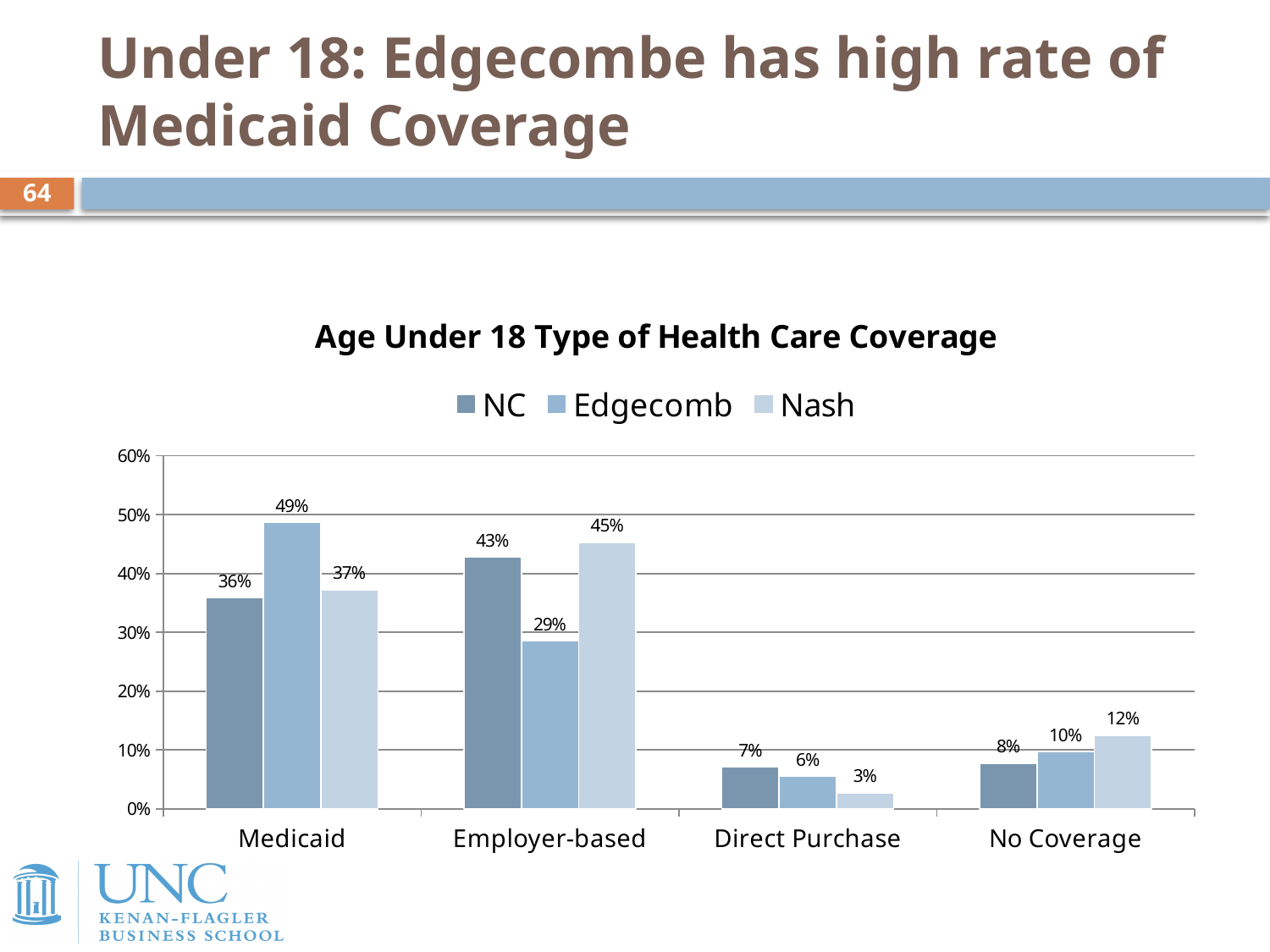
What kind of chart is shown on the slide? Bar chart Which category has the highest Edgecomb value? Medicaid What is the title of the chart? Age Under 18 Type of Health Care Coverage Which category has the lowest Nash value? Direct Purchase Is the Nash value for No Coverage greater or less than 10%? greater How many coverage categories are shown on the x axis? 4 What is the difference between the Edgecomb and NC values for Medicaid? 13% Which is larger for Employer-based coverage, the NC value or the Edgecomb value? NC What is the NC value for Direct Purchase? 7% How many series does the legend list? 3 What is the Edgecomb value for Medicaid? 49% What is the Nash value for Employer-based coverage? 45%